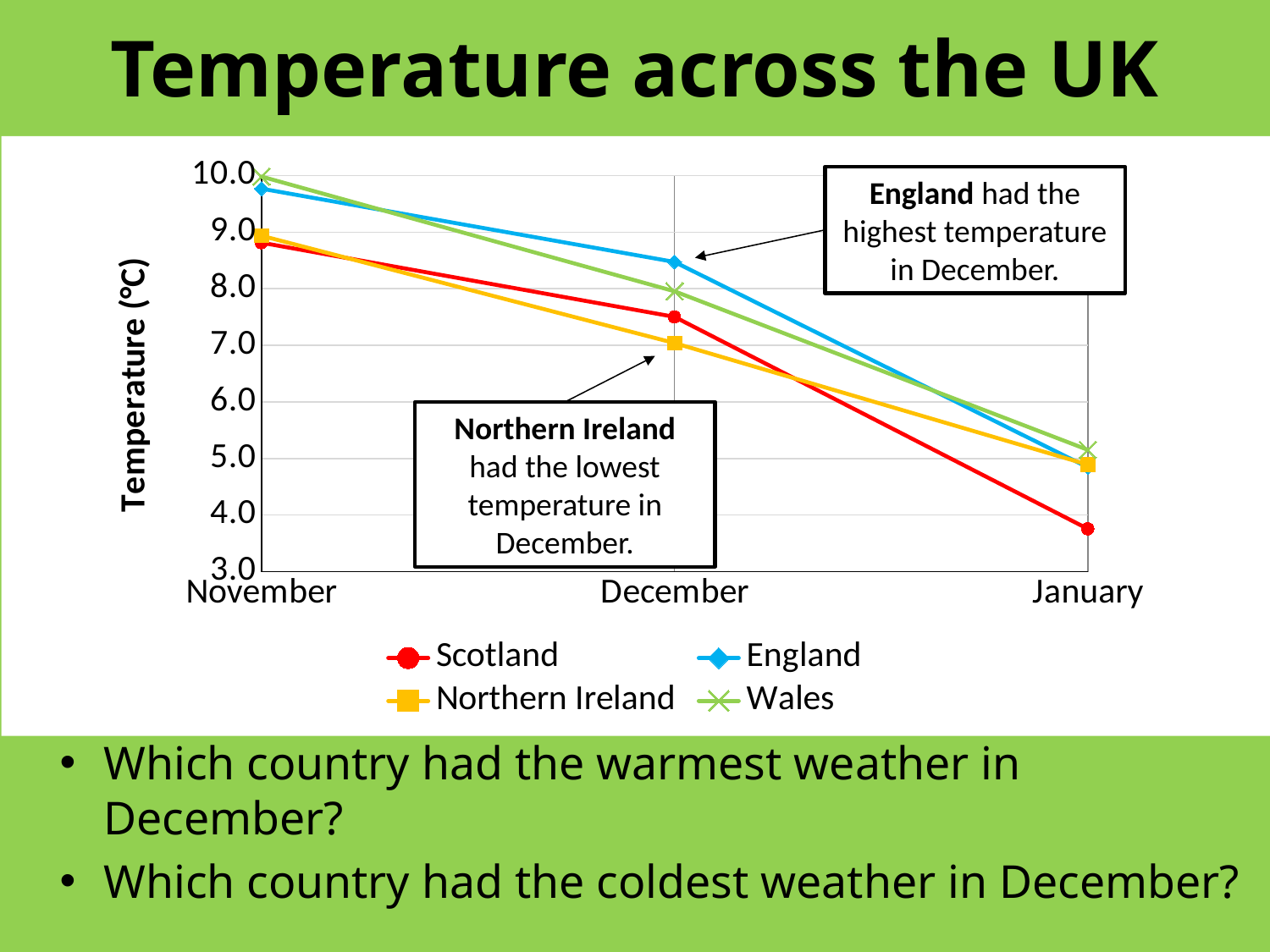
Which country had the lowest temperature in December? Northern Ireland In December, which is larger, the value for England or the value for Scotland? England Which country had the highest temperature in December? England Do the temperatures rise or fall from November to January? fall How many months are shown on the x axis? 3 Is the value for Scotland in December greater or less than 7.0? greater Is the value for Scotland in January greater or less than 4.0? less Which country had the lowest temperature in January? Scotland How many series does the legend list? 4 Is the value for England in December greater or less than 8.0? greater What kind of chart is shown on the slide? line chart What is the title of the y axis? Temperature (°C)